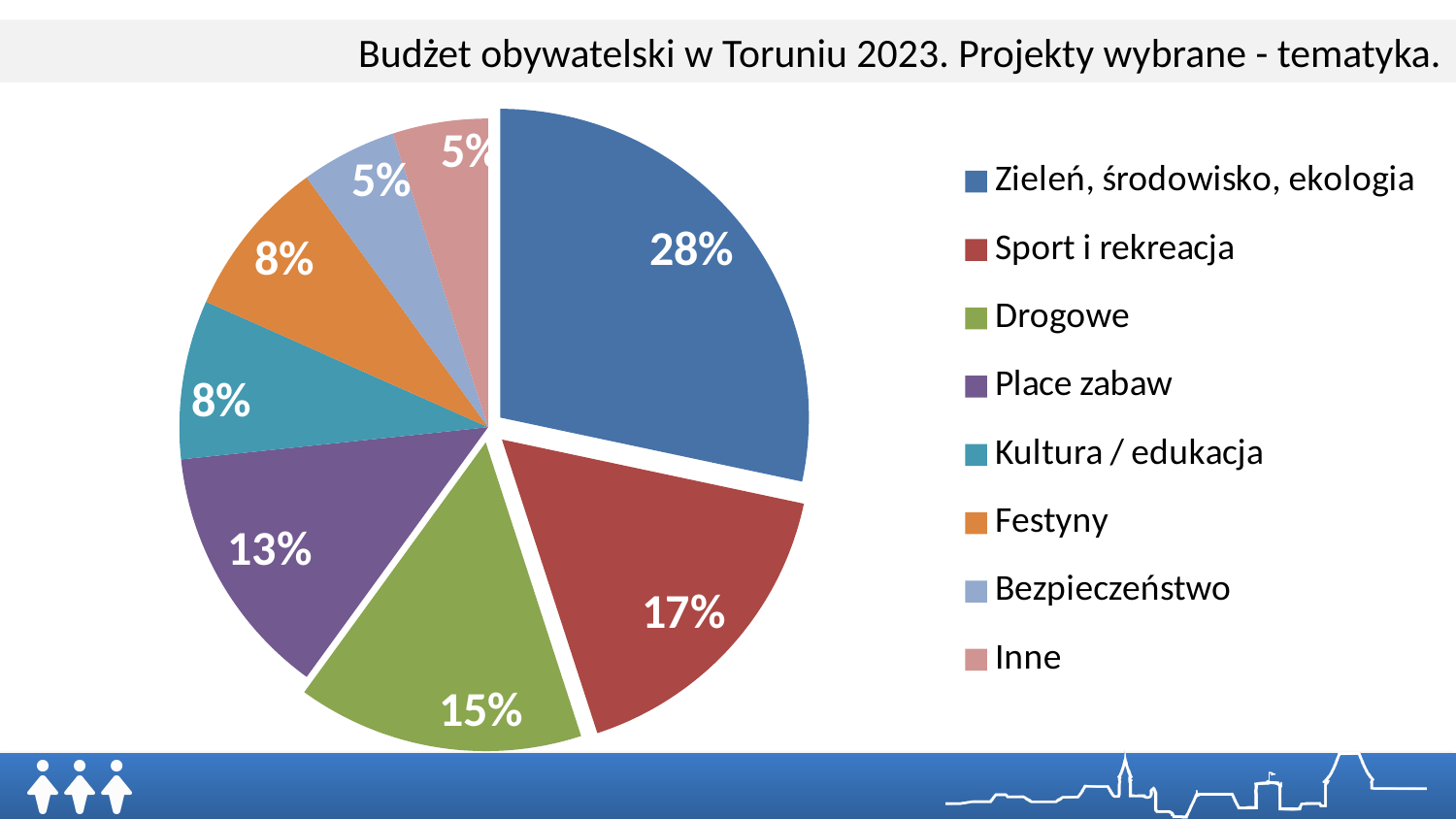
What type of chart is shown on the slide? Pie chart What percentage does Bezpieczeństwo account for? 5% What percentage is shown for Sport i rekreacja? 17% Which is larger, Sport i rekreacja or Drogowe? Sport i rekreacja How many categories does the pie chart show? 8 What share is labelled for Place zabaw? 13% What is the difference in percentage points between Zieleń, środowisko, ekologia and Sport i rekreacja? 11 percentage points What is the title of the chart? Budżet obywatelski w Toruniu 2023. Projekty wybrane - tematyka. What share of the pie does Zieleń, środowisko, ekologia have? 28% Which category has the largest slice of the pie? Zieleń, środowisko, ekologia Which category is shown in orange in the legend? Festyny What is the value for Drogowe? 15%